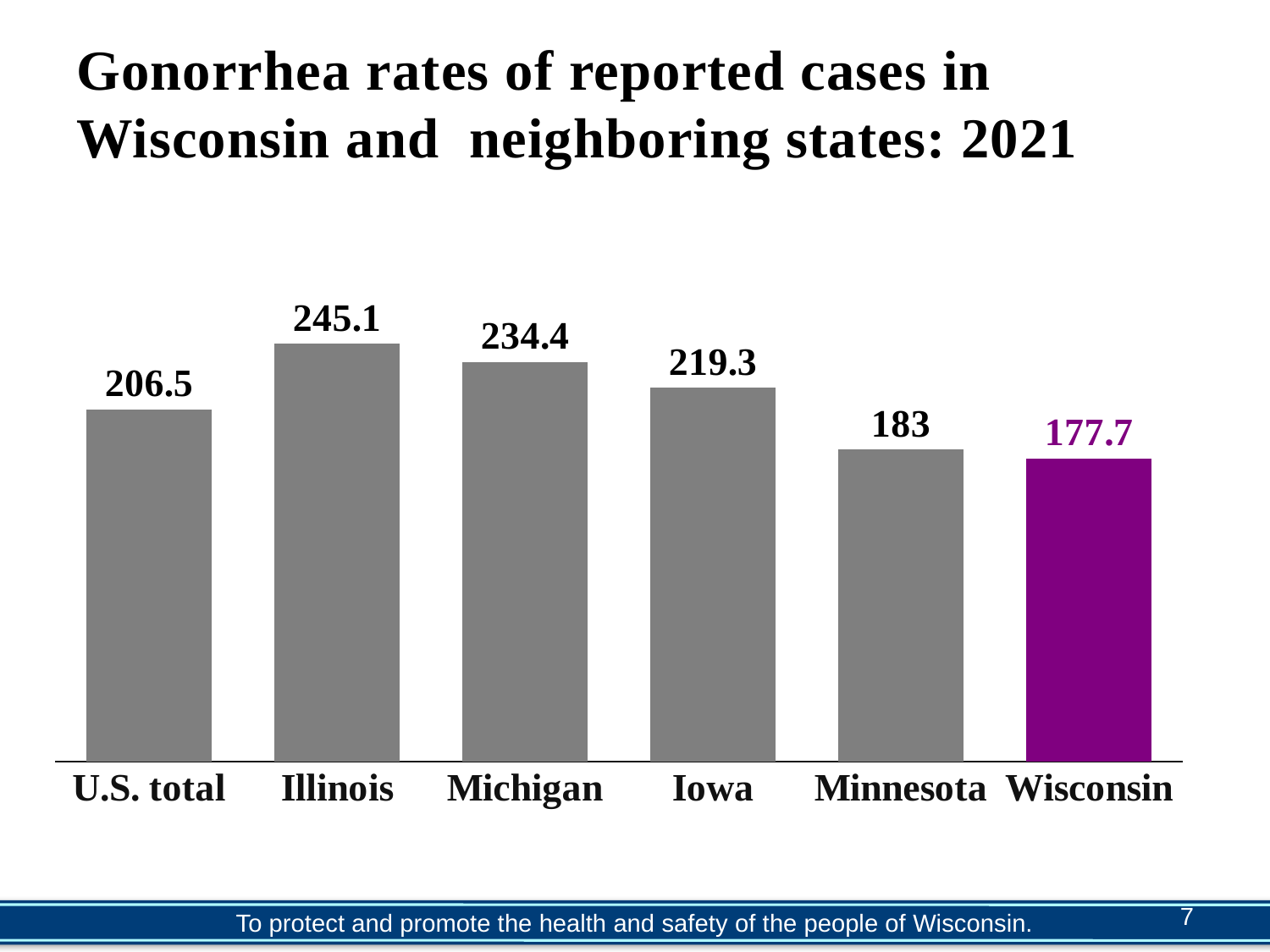
What is the difference between the values for Michigan and Iowa? 15.1 What is the difference between the values for Illinois and Wisconsin? 67.4 Which is larger, the value for Iowa or the value for Minnesota? Iowa What is the gonorrhea rate shown for Wisconsin? 177.7 Which category has the highest value? Illinois How many categories are shown on the chart? 6 Which bar is shown in a different colour (purple) from the others? Wisconsin Which category has the lowest value? Wisconsin What is the value shown for the U.S. total? 206.5 What is the value shown for Illinois? 245.1 What is the value shown for Minnesota? 183 What kind of chart is shown on the slide? Bar chart